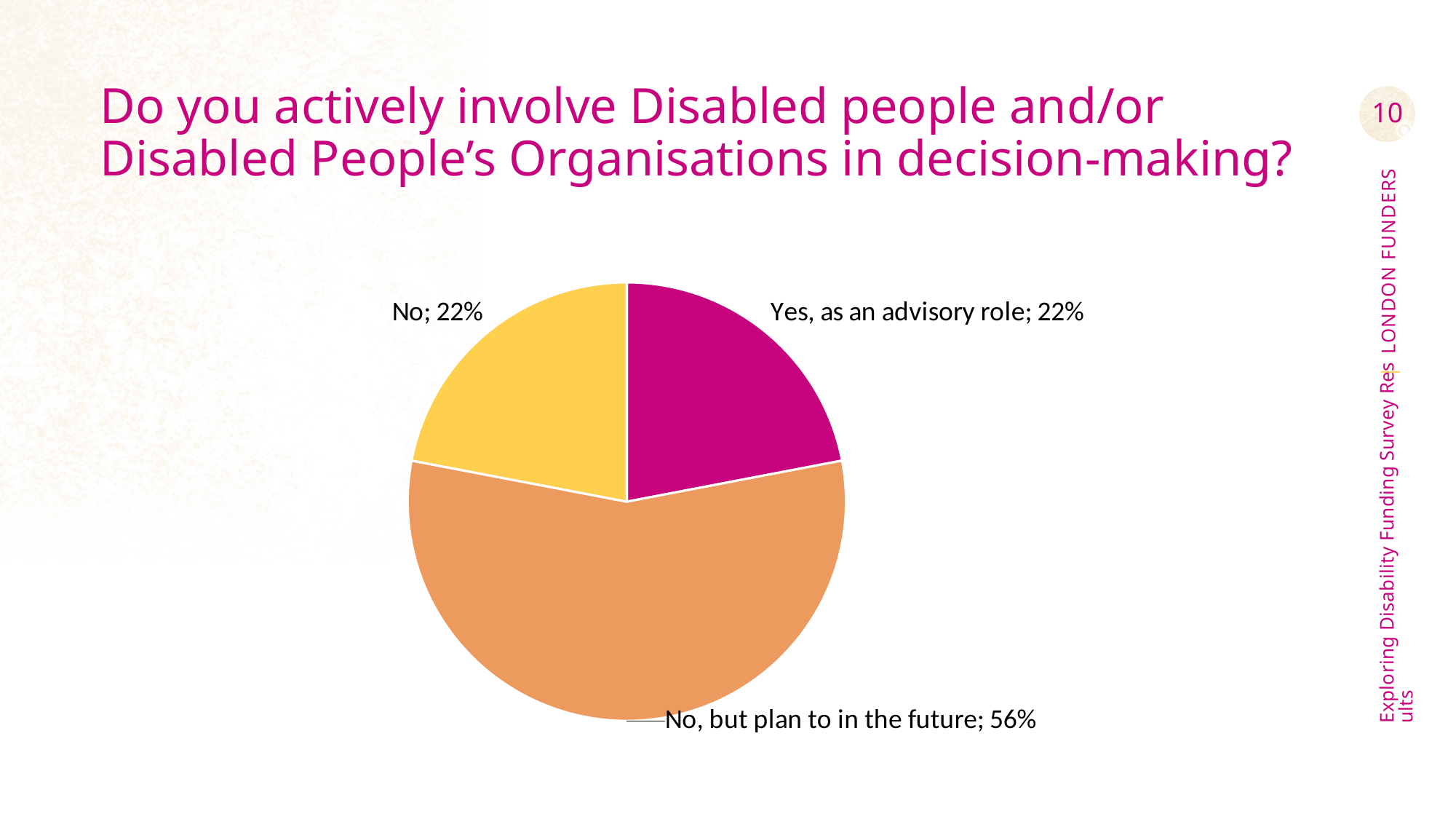
What kind of chart is shown on the slide? Pie chart Which response has the largest share of the pie? No, but plan to in the future What share of respondents answered "Yes, as an advisory role"? 22% Which is larger: the share for "No, but plan to in the future" or the share for "Yes, as an advisory role"? No, but plan to in the future What share of respondents answered "No"? 22% Which slice of the pie is coloured magenta? Yes, as an advisory role Which slice of the pie is coloured yellow? No What is the combined share of the two "No" responses ("No" and "No, but plan to in the future")? 78% What share of respondents answered "No, but plan to in the future"? 56% What is the difference in percentage points between "No, but plan to in the future" and "No"? 34 How many slices does the pie chart have? 3